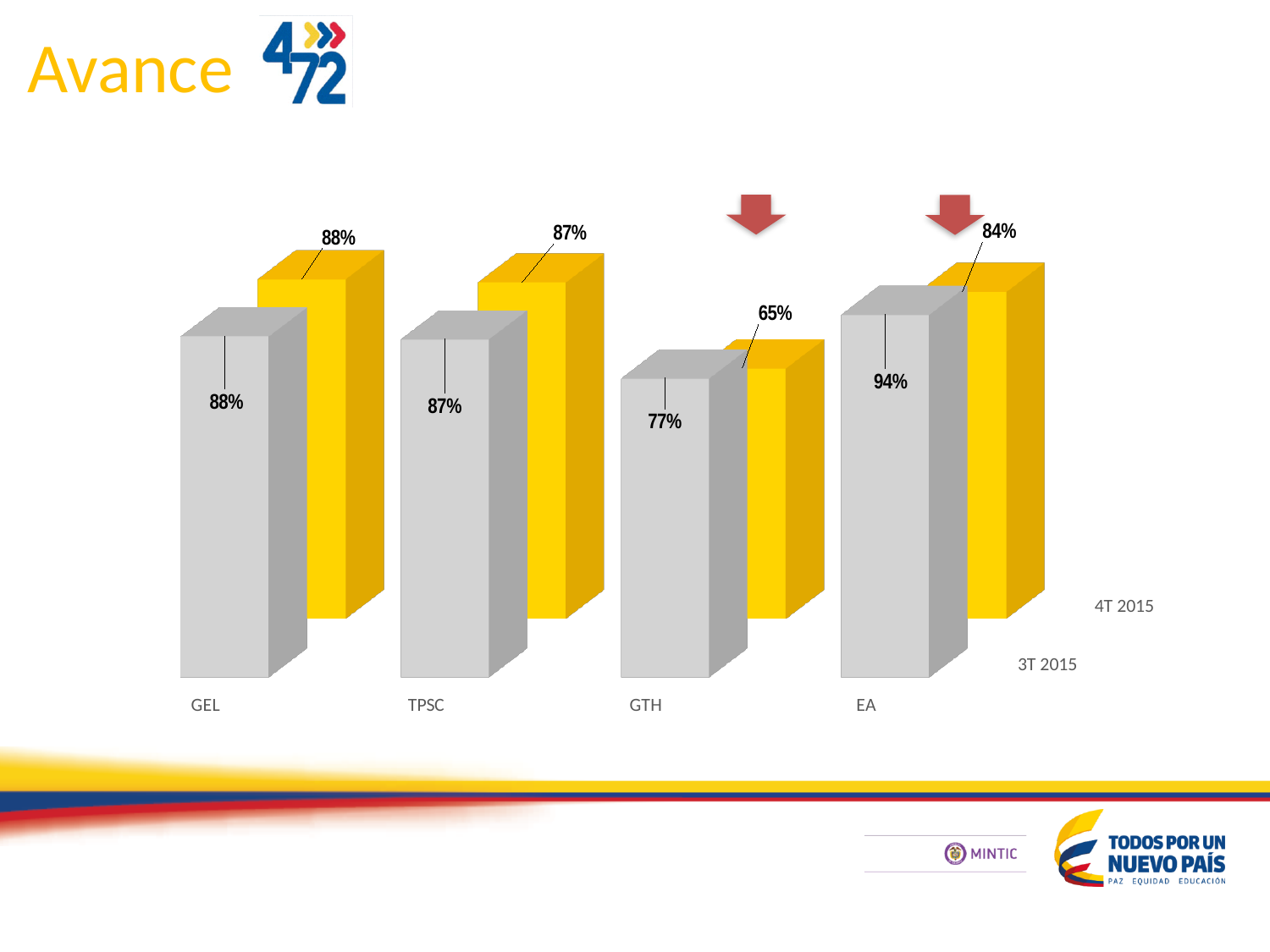
What is the value for TPSC in 3T 2015? 87% Which category has the highest value in 3T 2015? EA What is the difference between the 3T 2015 and 4T 2015 values for EA? 10% Which is larger for EA: the 3T 2015 value or the 4T 2015 value? 3T 2015 How many series does the chart show? 2 What is the value for EA in 4T 2015? 84% What kind of chart is shown on the slide? Bar chart What is the value for GTH in 3T 2015? 77% What is the difference between the 3T 2015 and 4T 2015 values for GTH? 12% What is the value for GEL in 4T 2015? 88% Which category has the lowest value in 4T 2015? GTH How many categories are shown on the x axis? 4